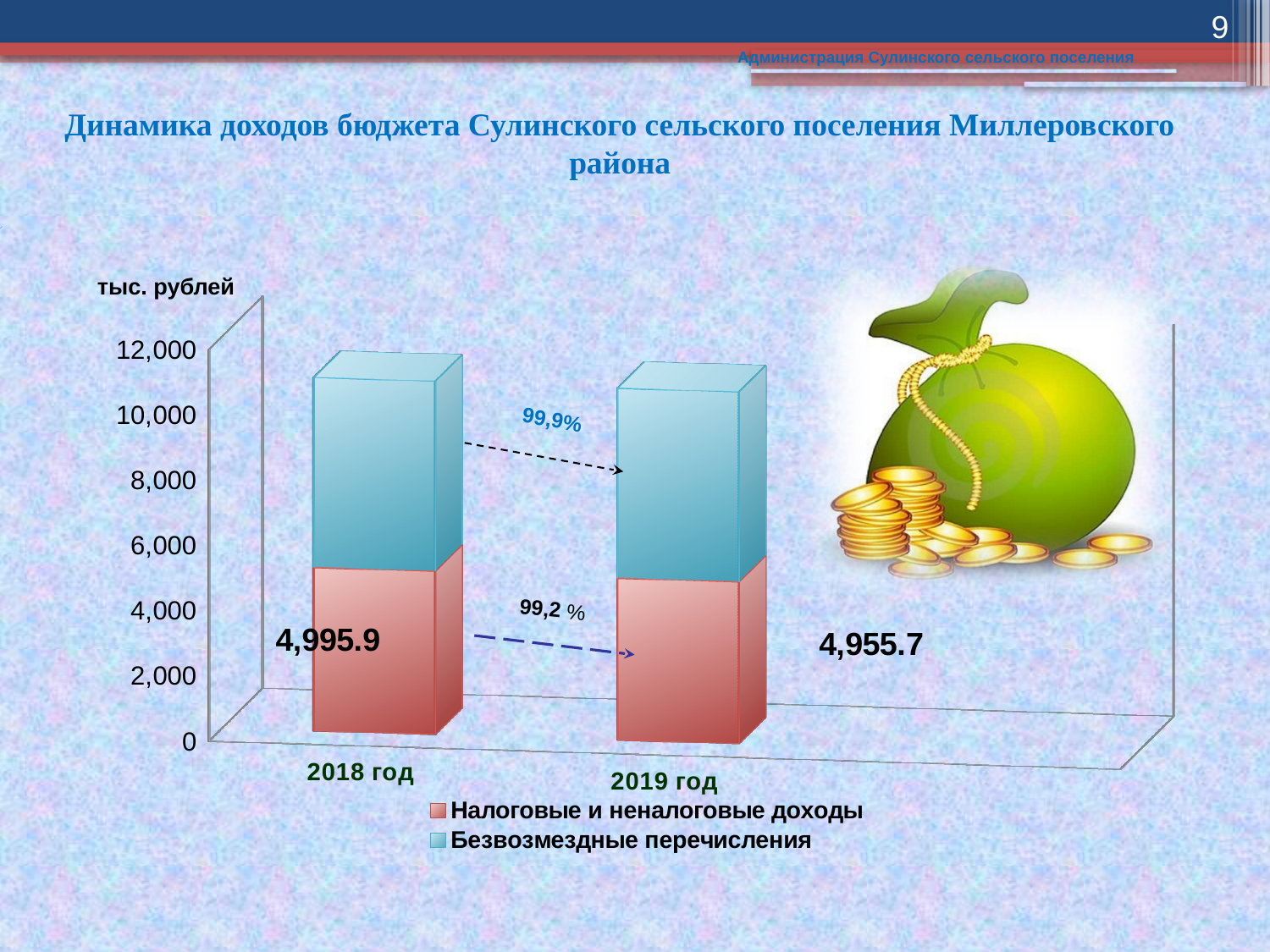
What is the value of Налоговые и неналоговые доходы for 2019 год? 4,955.7 What percentage is printed on the arrow between the Налоговые и неналоговые доходы segments of the two bars? 99,2 % What is the value of Налоговые и неналоговые доходы for 2018 год? 4,995.9 Is the total height of the stacked bar for 2018 год greater or less than 10,000? greater How many series does the chart legend list? 2 How many years (categories) are plotted on the x axis of the chart? 2 What kind of chart is shown on the slide? Stacked bar chart Which year has the larger value of Налоговые и неналоговые доходы, 2018 год or 2019 год? 2018 год Do the Налоговые и неналоговые доходы values rise or fall from 2018 год to 2019 год? fall What is the difference between the Налоговые и неналоговые доходы values for 2018 год and 2019 год? 40.2 What unit label is printed above the vertical axis of the chart? тыс. рублей Which series is shown in red in the chart legend? Налоговые и неналоговые доходы